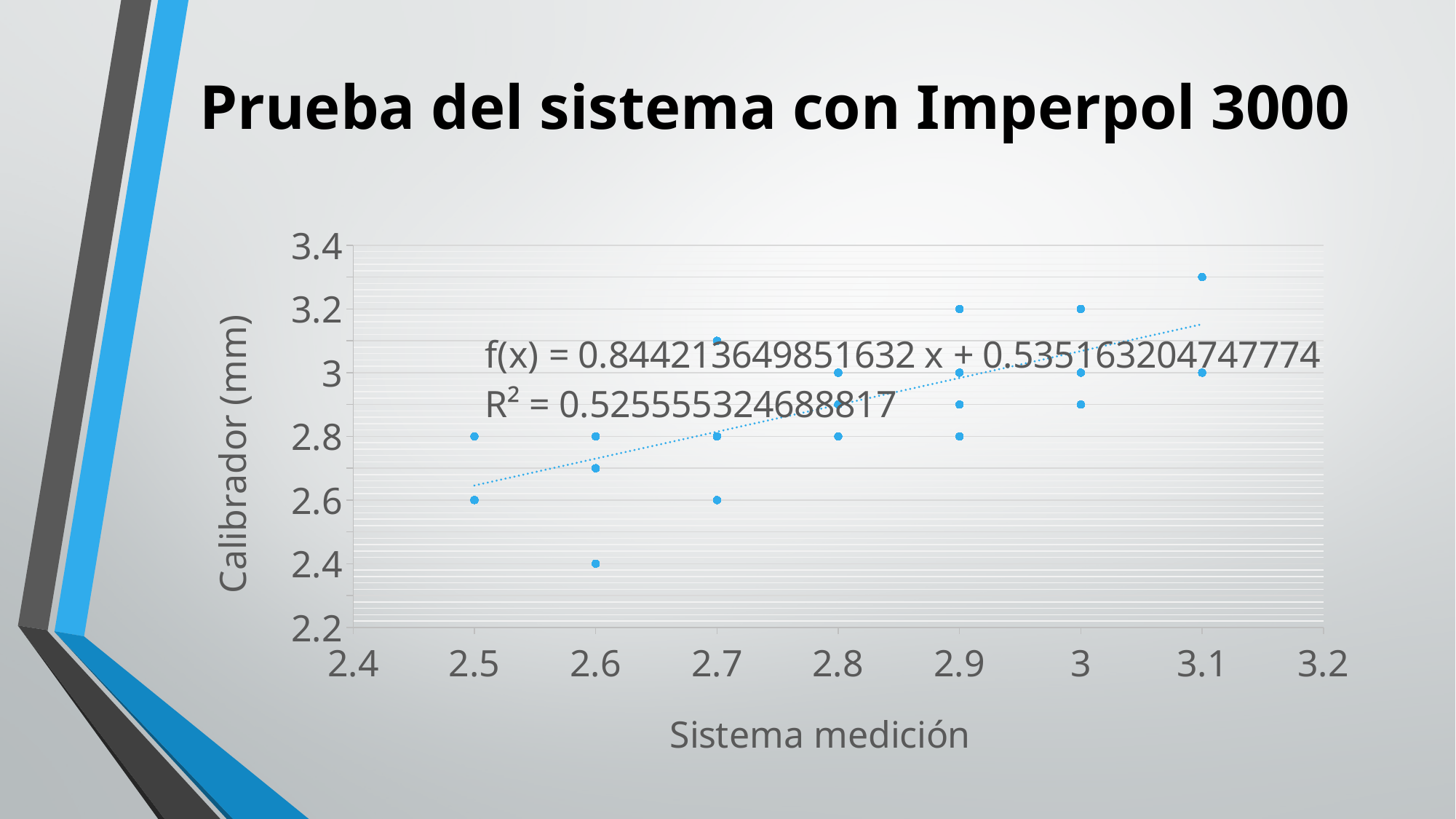
What is the intercept in the trendline equation printed on the chart? 0.535163204747774 What is the title of the x axis of the chart? Sistema medición What kind of chart is shown on the slide? scatter chart What is the title of the y axis of the chart? Calibrador (mm) What R² value is printed on the chart? 0.5255553246888817 At which Sistema medición value does the highest point on the chart occur? 3.1 What is the lowest Calibrador (mm) value plotted on the chart? 2.4 At which Sistema medición value does the lowest point on the chart occur? 2.6 Does the trendline rise or fall as Sistema medición increases? rise Is the trendline value at Sistema medición = 3.1 greater or less than 3.2? less